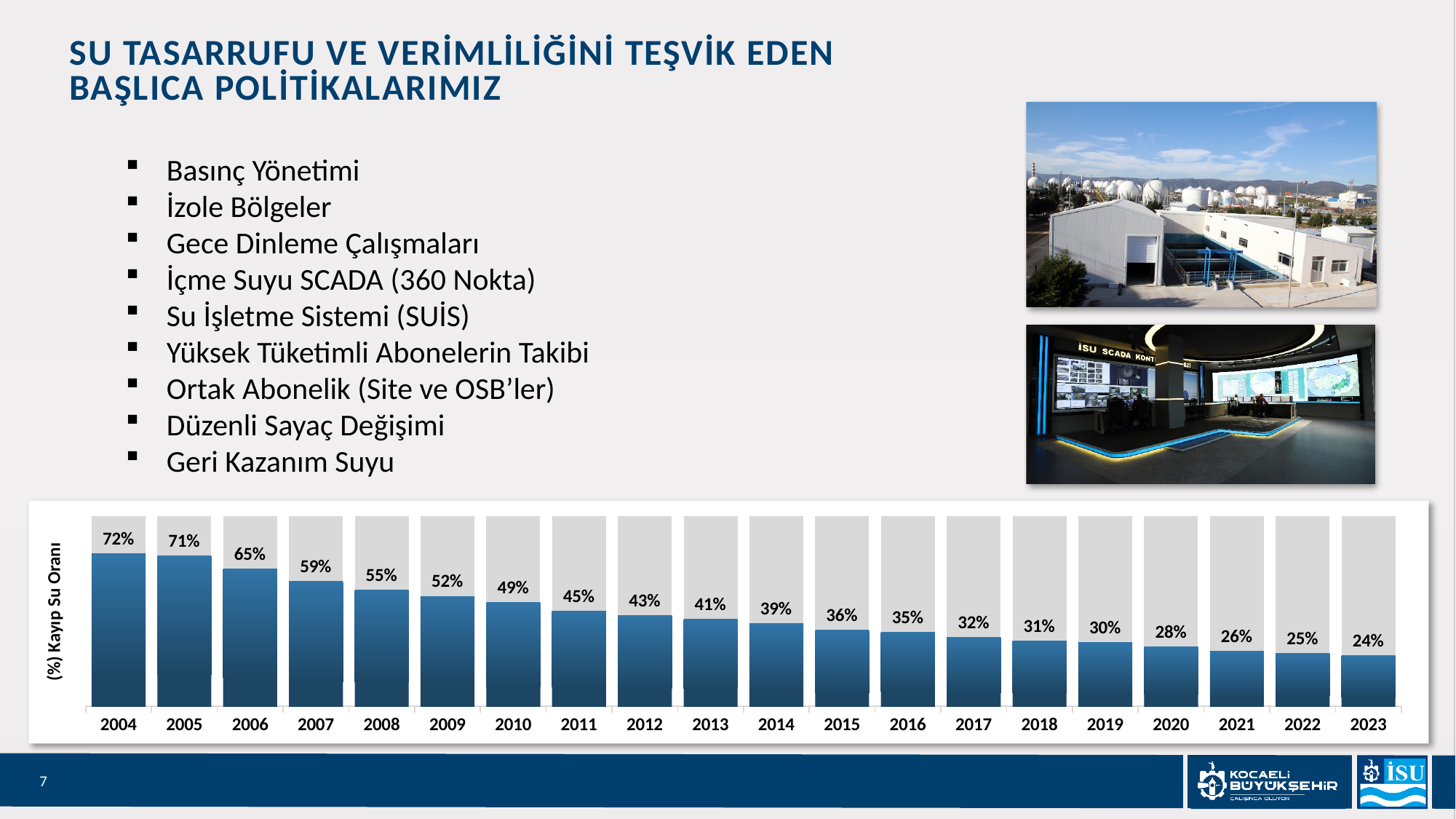
What is the difference between the water loss rate in 2004 and in 2023? 48% What is the water loss rate (Kayıp Su Oranı) shown for 2004? 72% How many years are shown on the x axis of the chart? 20 What is the label on the vertical axis of the chart? (%) Kayıp Su Oranı Do the water loss rate values rise or fall from 2004 to 2023? Fall Which year has the lowest water loss rate? 2023 Which year has a higher water loss rate, 2008 or 2012? 2008 What is the water loss rate shown for 2023? 24% What is the water loss rate shown for 2014? 39% What kind of chart is used to show the water loss rate? Bar chart Which year has the highest water loss rate? 2004 What is the water loss rate shown for 2010? 49%